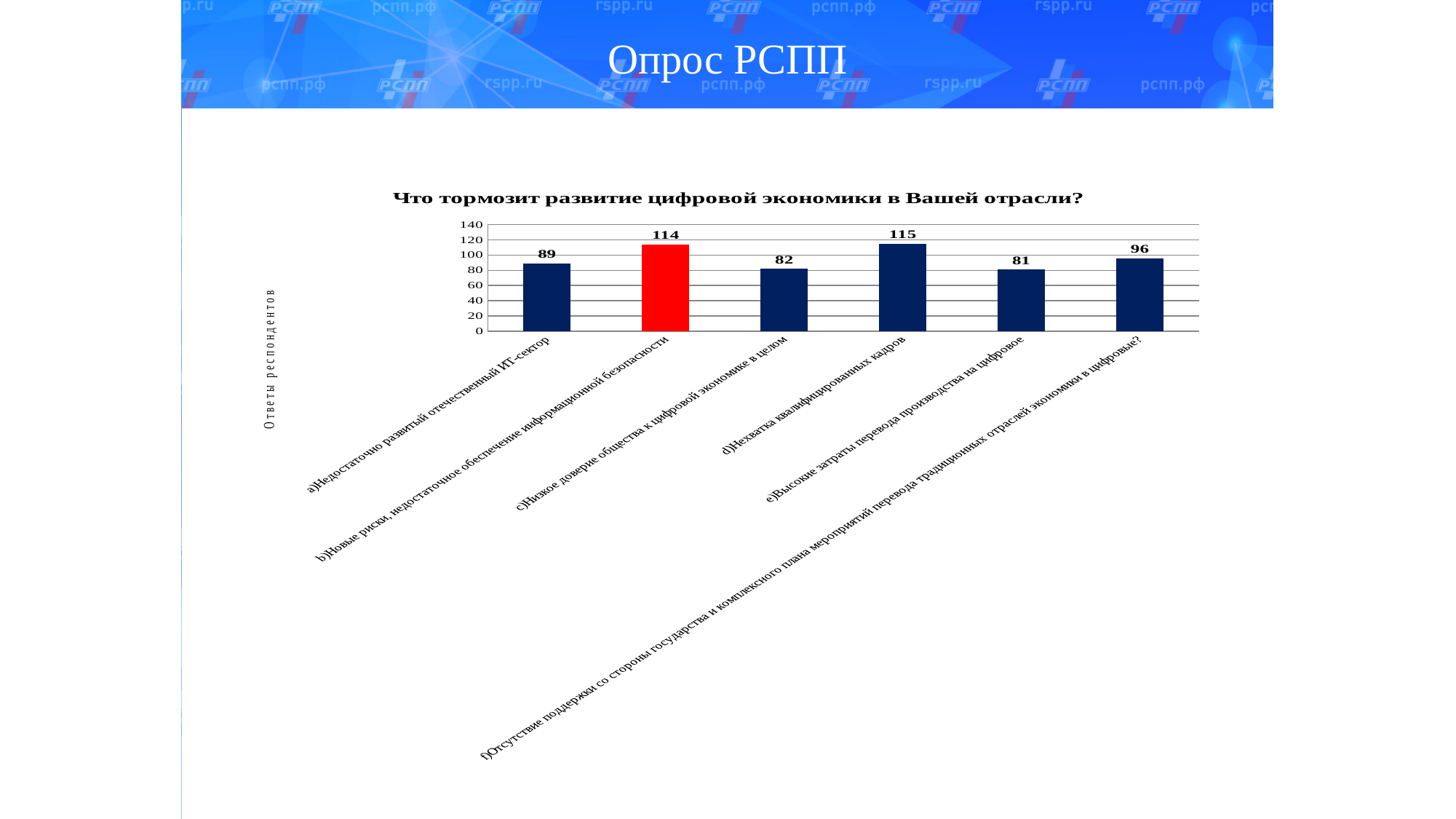
What is the value for 'e) Высокие затраты перевода производства на цифровое'? 81 What is the difference between the values for 'b) Новые риски, недостаточное обеспечение информационной безопасности' and 'a) Недостаточно развитый отечественный ИТ-сектор'? 25 What is the title of the chart? Что тормозит развитие цифровой экономики в Вашей отрасли? Which bar is coloured red rather than dark blue? b) Новые риски, недостаточное обеспечение информационной безопасности What is the value for 'a) Недостаточно развитый отечественный ИТ-сектор'? 89 What is the value for 'c) Низкое доверие общества к цифровой экономике в целом'? 82 Which category has the lowest value? e) Высокие затраты перевода производства на цифровое What type of chart is shown on the slide? bar chart Which category has the highest value? d) Нехватка квалифицированных кадров Which is larger: the value for 'f) Отсутствие поддержки со стороны государства...' or the value for 'c) Низкое доверие общества к цифровой экономике в целом'? f) Отсутствие поддержки со стороны государства... How many categories (bars) does the chart show? 6 What is the value for 'd) Нехватка квалифицированных кадров'? 115